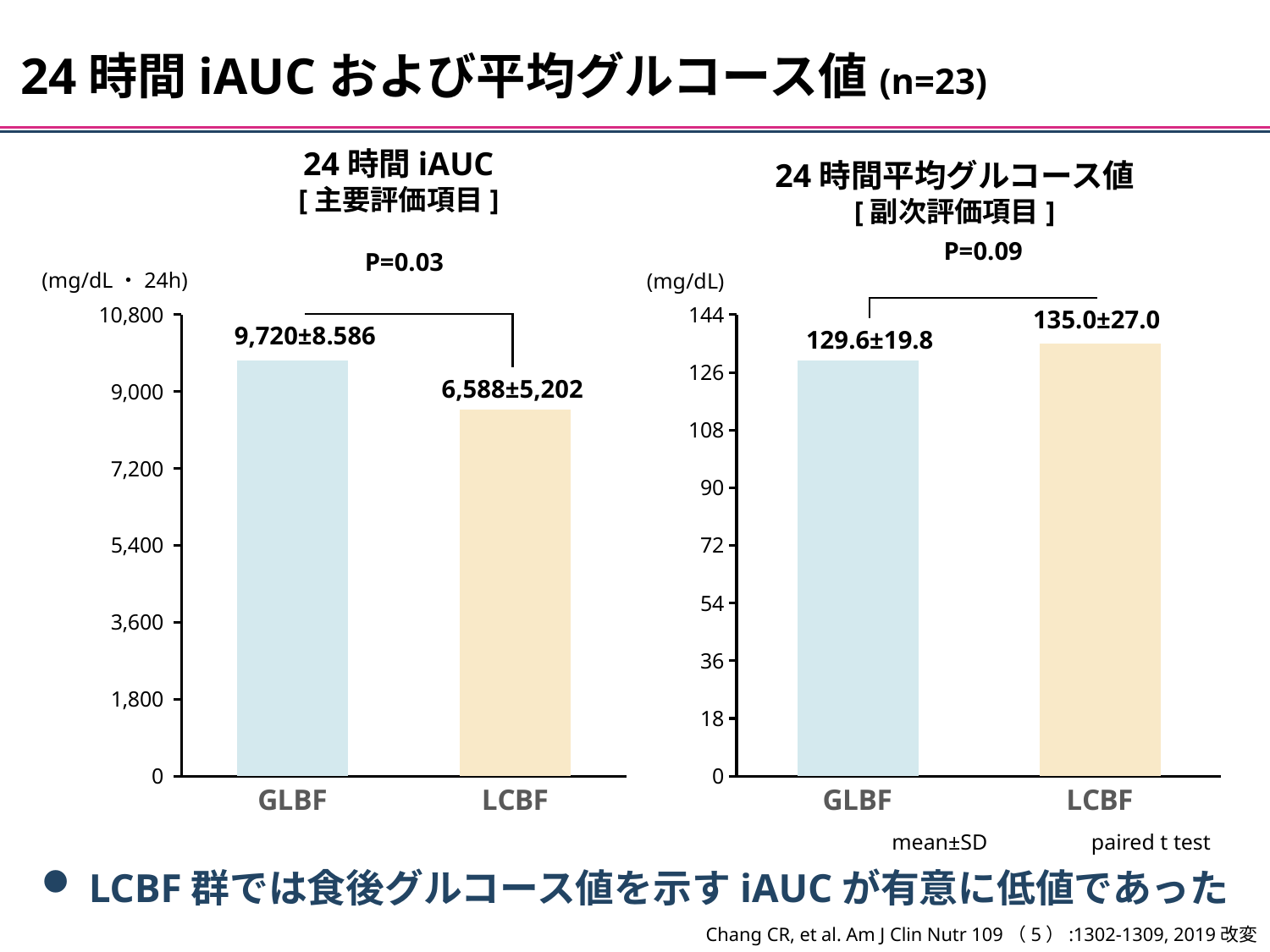
On the left chart (24 時間 iAUC), what value is labelled for LCBF? 6,588±5,202 What P value is shown above the right chart (24 時間平均グルコース値)? P=0.09 On the left chart (24 時間 iAUC), which group has the higher bar? GLBF On the right chart (24 時間平均グルコース値), which group has the lower bar? GLBF On the right chart (24 時間平均グルコース値), is the value for GLBF greater or less than 126? greater On the left chart (24 時間 iAUC), what value is labelled for GLBF? 9,720±8.586 On the right chart (24 時間平均グルコース値), what value is labelled for GLBF? 129.6±19.8 On the right chart (24 時間平均グルコース値), what is the difference between the LCBF mean (135.0) and the GLBF mean (129.6)? 5.4 On the left chart (24 時間 iAUC), what is the difference between the GLBF mean (9,720) and the LCBF mean (6,588)? 3,132 What kind of chart is used on the left (24 時間 iAUC)? bar chart On the right chart (24 時間平均グルコース値), what value is labelled for LCBF? 135.0±27.0